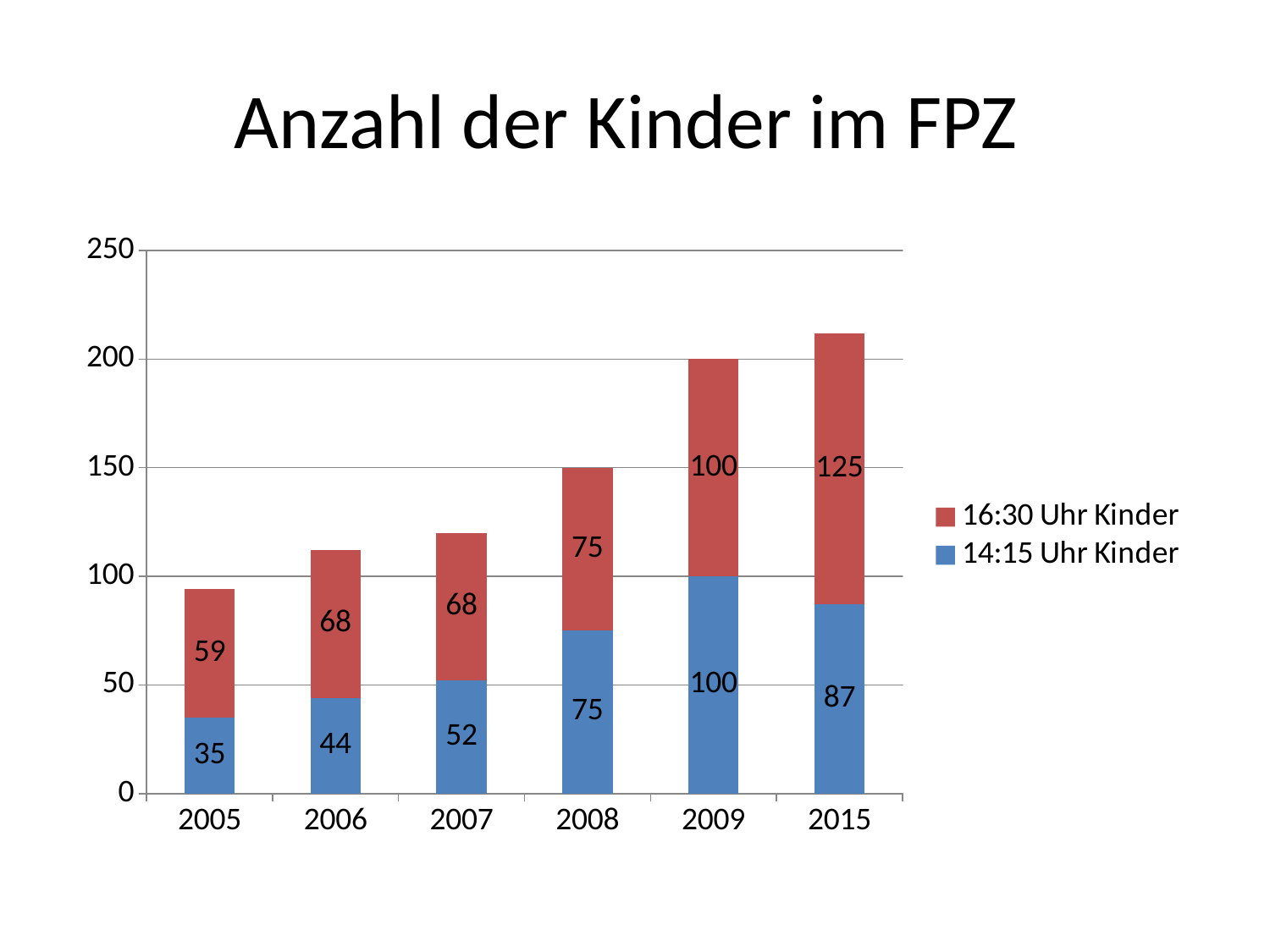
What is the value for 14:15 Uhr Kinder in 2015? 87 What is the value for 16:30 Uhr Kinder in 2008? 75 What is the total of the stacked bar for 2008? 150 Which is larger: the 14:15 Uhr Kinder value in 2009 or in 2015? 2009 Which year has the highest value for 16:30 Uhr Kinder? 2015 What is the difference between the 16:30 Uhr Kinder values for 2015 and 2009? 25 What is the total of the stacked bar for 2005? 94 What kind of chart is shown on the slide? Stacked bar chart What is the value for 14:15 Uhr Kinder in 2005? 35 How many years are shown on the x axis? 6 Which year has the lowest value for 14:15 Uhr Kinder? 2005 How many series does the legend list? 2